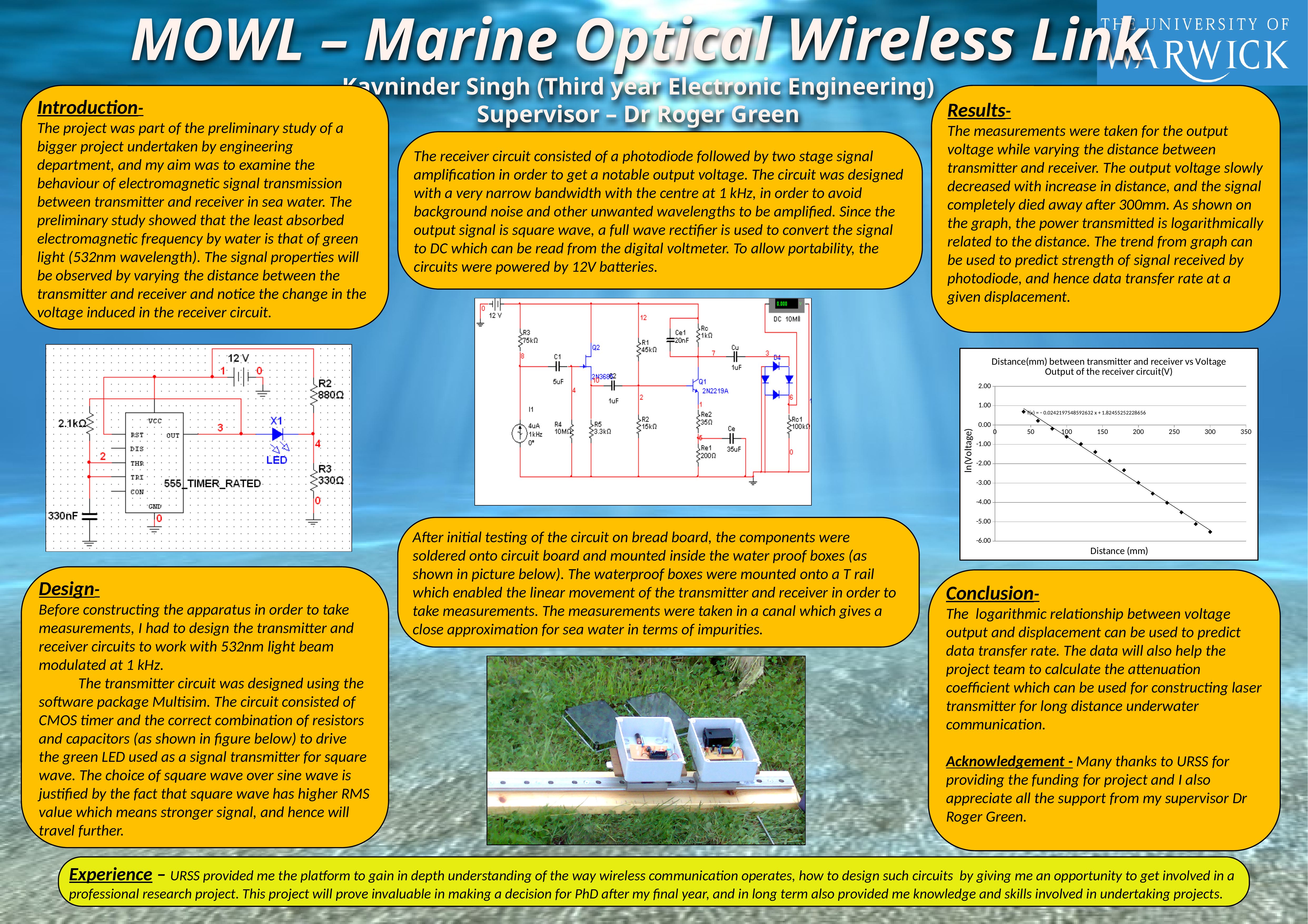
What kind of chart is shown on the slide? scatter chart Is the ln(Voltage) value of the leftmost data point greater or less than 0.00? greater Is the ln(Voltage) value at a distance of about 200 mm greater or less than -2.00? less Is the lowest ln(Voltage) value found at the smallest or the largest distance? largest distance Which has the larger ln(Voltage) value: the point at about 100 mm or the point at about 250 mm? 100 mm Is the slope of the fitted trendline positive or negative? negative Is the ln(Voltage) value of the rightmost data point greater or less than -4.00? less What is the title of the chart? Distance(mm) between transmitter and receiver vs Voltage Output of the receiver circuit(V) What is the label on the y axis of the chart? ln(Voltage) Is the highest ln(Voltage) value found at the smallest or the largest distance? smallest distance Do the ln(Voltage) values rise or fall as the distance increases along the x axis? fall